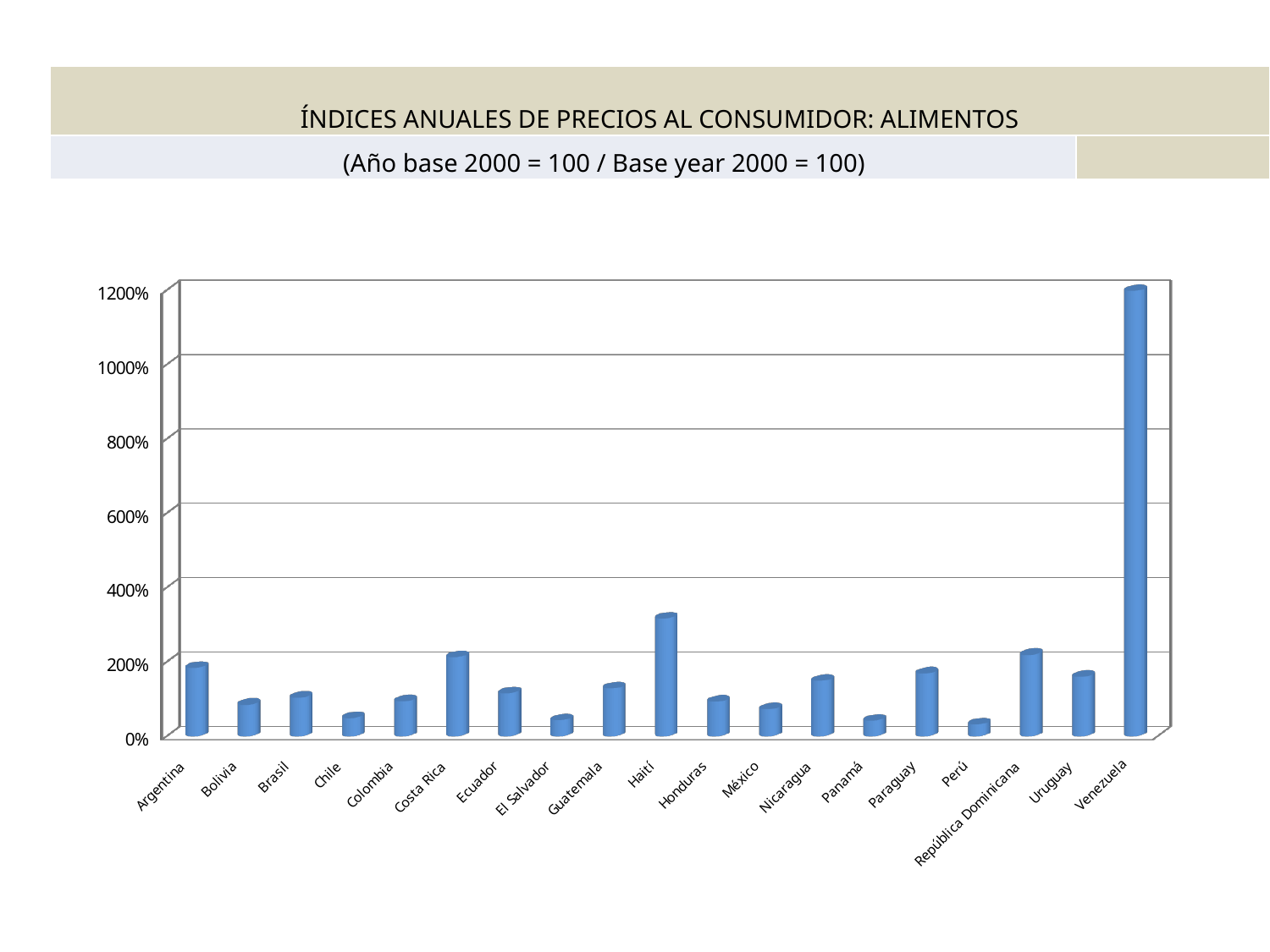
Is the value for Haití greater or less than 200%? greater What is the title of the chart on the slide? ÍNDICES ANUALES DE PRECIOS AL CONSUMIDOR: ALIMENTOS Is the value for Venezuela greater or less than 800%? greater Which is larger, the value for Nicaragua or the value for Panamá? Nicaragua Is the value for Paraguay greater or less than 400%? less How many countries are shown on the x axis of the chart? 19 What kind of chart is shown on the slide? bar chart Which is larger, the value for Haití or the value for Argentina? Haití Which country has the highest food consumer price index in the chart? Venezuela Which is larger, the value for Costa Rica or the value for Bolivia? Costa Rica